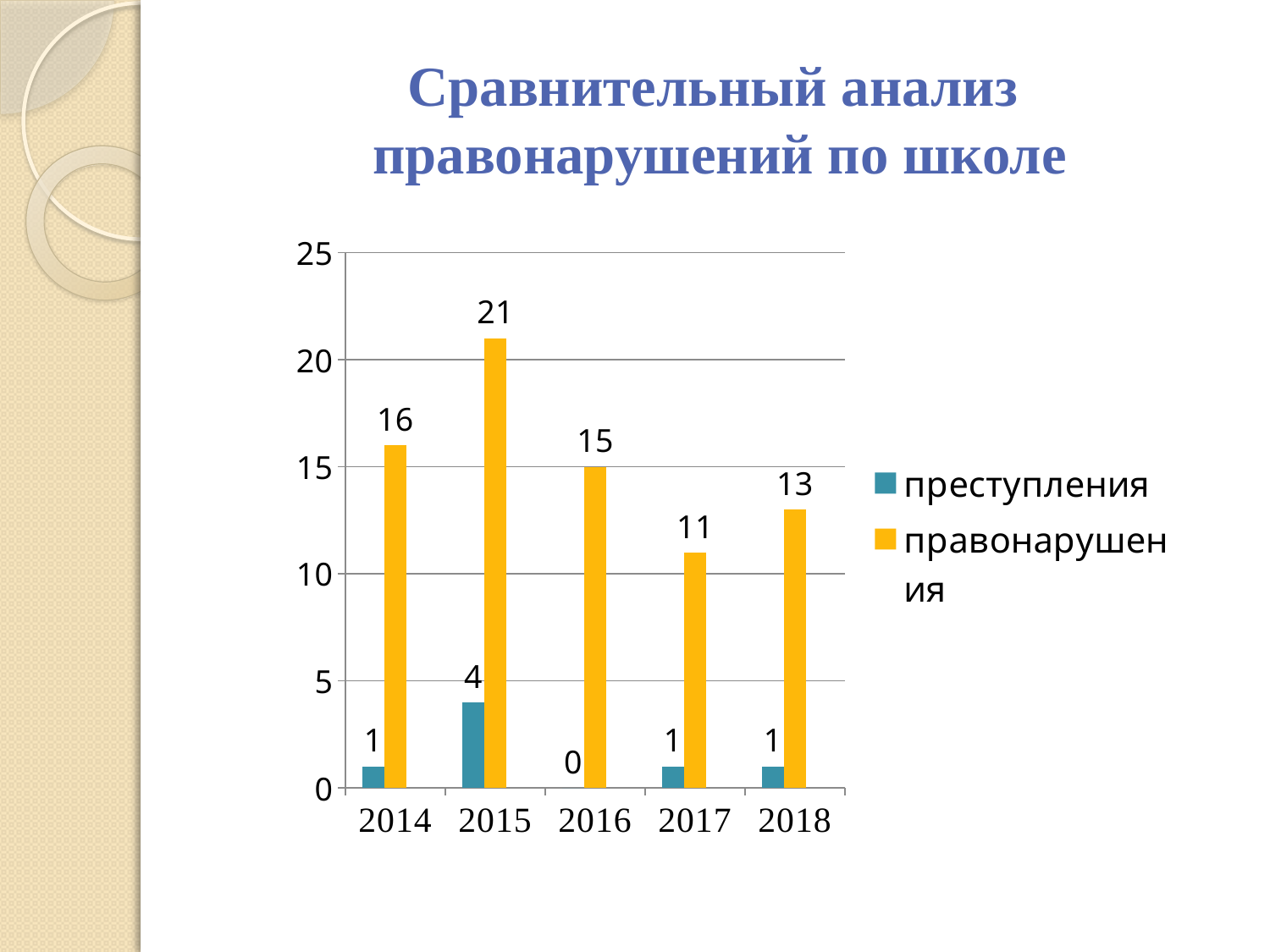
What kind of chart is shown on the slide? bar chart Which year has the lowest value for правонарушения? 2017 What is the value for правонарушения in 2018? 13 What is the value for преступления in 2016? 0 What is the value for правонарушения in 2015? 21 Which is larger, правонарушения in 2014 or in 2016? 2014 What is the value for преступления in 2015? 4 How many years are shown on the x axis? 5 What is the title of the slide? Сравнительный анализ правонарушений по школе Which year has the highest value for правонарушения? 2015 What is the difference between правонарушения in 2015 and 2017? 10 How many series does the legend list? 2